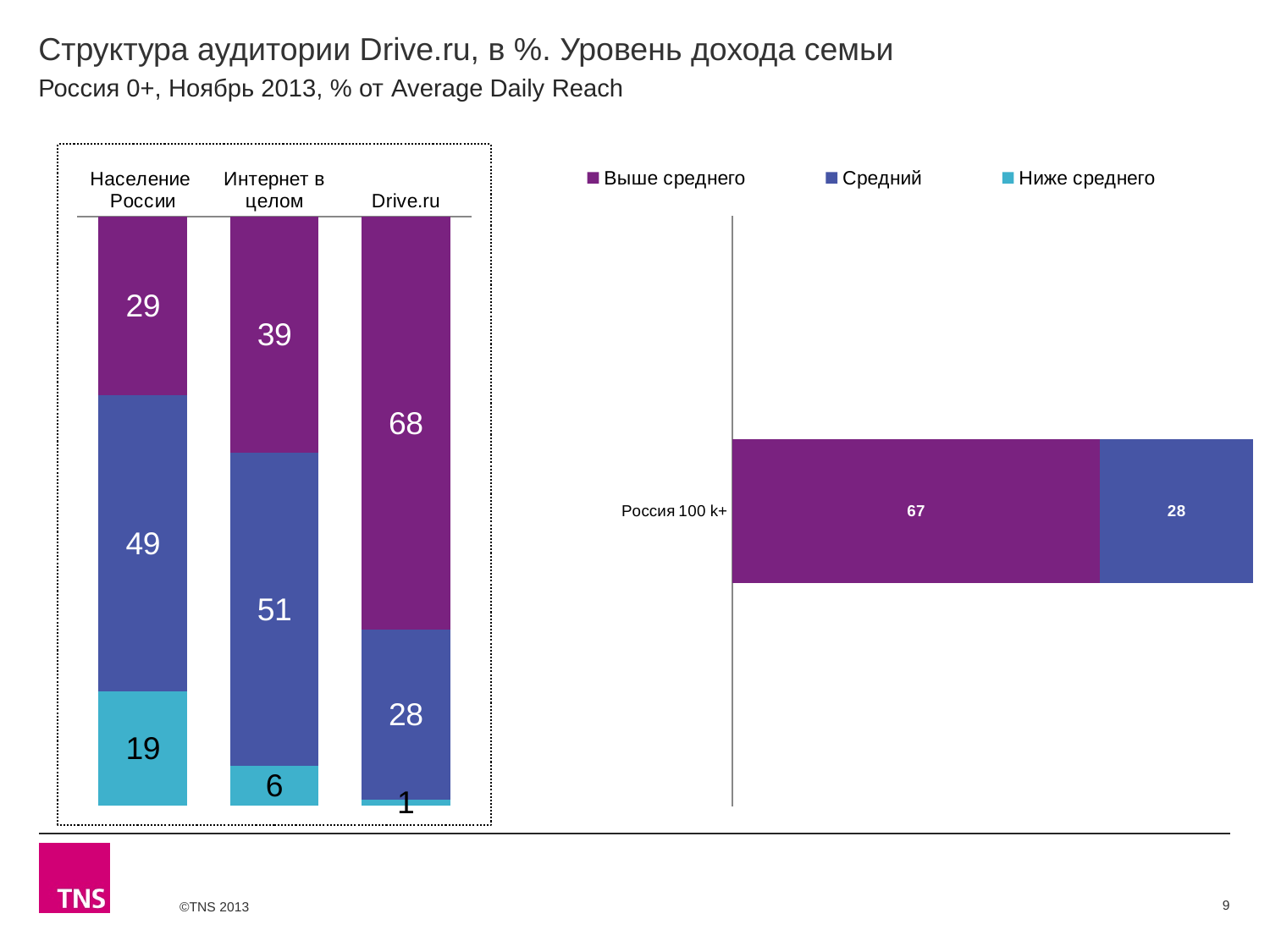
In the left chart, what is the value of the 'Средний' segment for 'Население России'? 49 How many categories are shown in the left chart? 3 In the left chart, is the 'Средний' value larger for 'Интернет в целом' or for Drive.ru? Интернет в целом In the left chart, what is the value of the 'Выше среднего' segment for Drive.ru? 68 How many series does the legend list? 3 In the right chart, what is the total of the labelled segments for 'Россия 100 k+'? 95 In the right chart, what is the 'Выше среднего' value for 'Россия 100 k+'? 67 In the left chart, what is the difference between the 'Выше среднего' values for Drive.ru and 'Население России'? 39 In the left chart, which category has the highest 'Выше среднего' value? Drive.ru In the left chart, what is the value of the 'Ниже среднего' segment for 'Интернет в целом'? 6 What kind of chart is the right chart? Stacked bar chart In the left chart, which category has the lowest 'Ниже среднего' value? Drive.ru